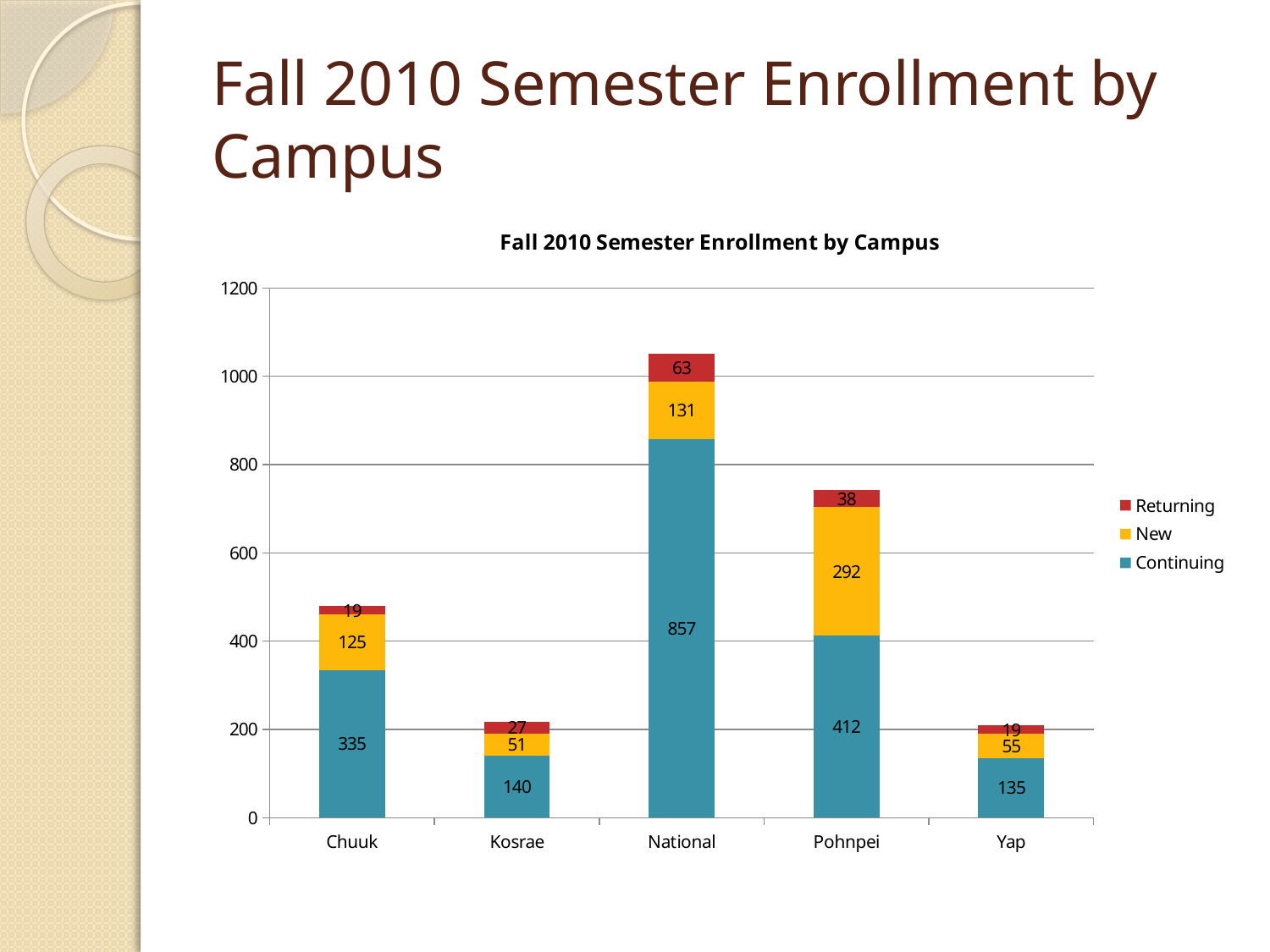
What is the difference between the Continuing enrollment for Chuuk and for Yap? 200 How many series does the legend list? 3 What is the Continuing enrollment for National? 857 Which campus has the highest Continuing enrollment? National What is the total enrollment for Kosrae? 218 Which campus has the lowest New enrollment? Kosrae Which is larger, the New enrollment for Chuuk or the New enrollment for National? National What is the Returning enrollment for Kosrae? 27 How many campuses are shown on the x axis? 5 What is the New enrollment for Pohnpei? 292 What is the total enrollment for Pohnpei? 742 What kind of chart is shown? Stacked bar chart